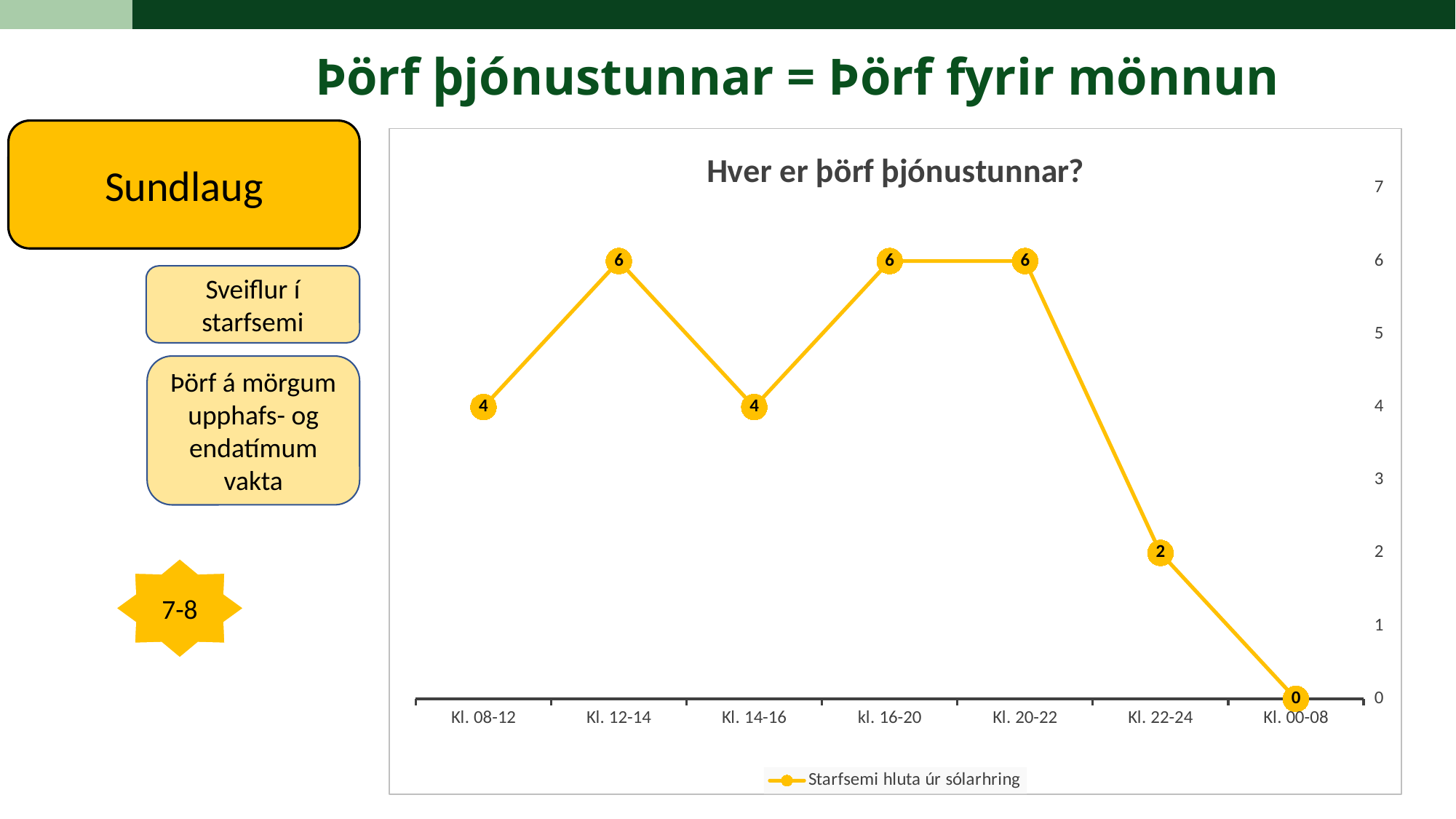
What is the value for Kl. 00-08? 0 What is the value for Kl. 20-22? 6 What is the difference between the values for Kl. 12-14 and Kl. 14-16? 2 How many categories are shown on the x axis? 7 What is the title of the chart? Hver er þörf þjónustunnar? Which is larger, the value for Kl. 08-12 or the value for Kl. 22-24? Kl. 08-12 Is the value for Kl. 12-14 greater or less than 5? greater How many series does the legend list? 1 What is the value for Kl. 08-12? 4 Which category has the lowest value? Kl. 00-08 What is the value for Kl. 22-24? 2 What kind of chart is shown? line chart